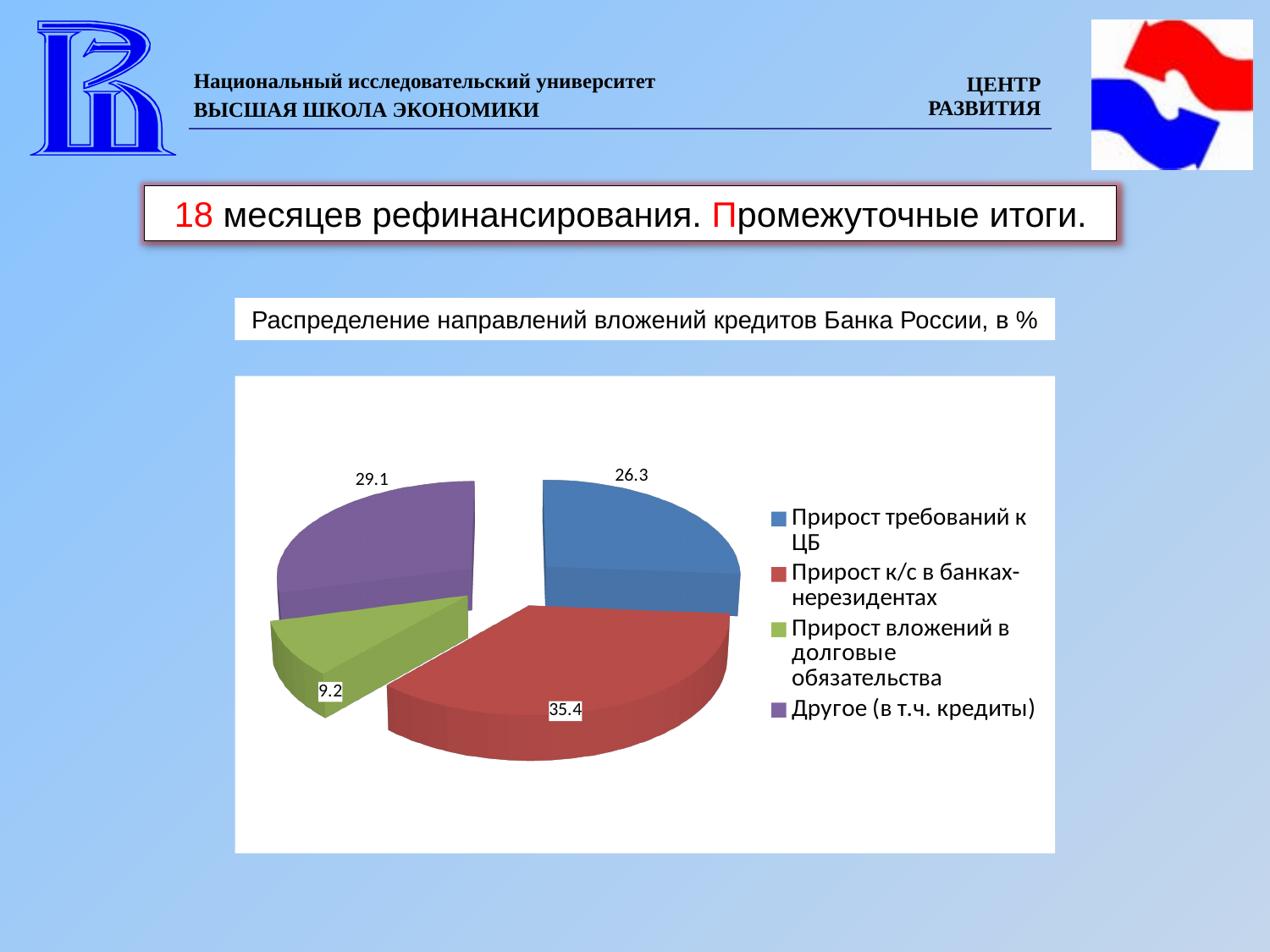
What kind of chart is shown on the slide? pie chart Which category has the largest slice of the pie? Прирост к/с в банках-нерезидентах Which is larger: the value for "Другое (в т.ч. кредиты)" or the value for "Прирост требований к ЦБ"? Другое (в т.ч. кредиты) What is the value for "Прирост требований к ЦБ"? 26.3 Which category has the smallest slice of the pie? Прирост вложений в долговые обязательства What is the difference between the values for "Прирост к/с в банках-нерезидентах" and "Прирост требований к ЦБ"? 9.1 What is the value for "Прирост к/с в банках-нерезидентах"? 35.4 What is the value for "Прирост вложений в долговые обязательства"? 9.2 What is the value for "Другое (в т.ч. кредиты)"? 29.1 What colour is the slice for "Прирост вложений в долговые обязательства"? green How many slices does the pie chart have? 4 What is the title of the chart? Распределение направлений вложений кредитов Банка России, в %